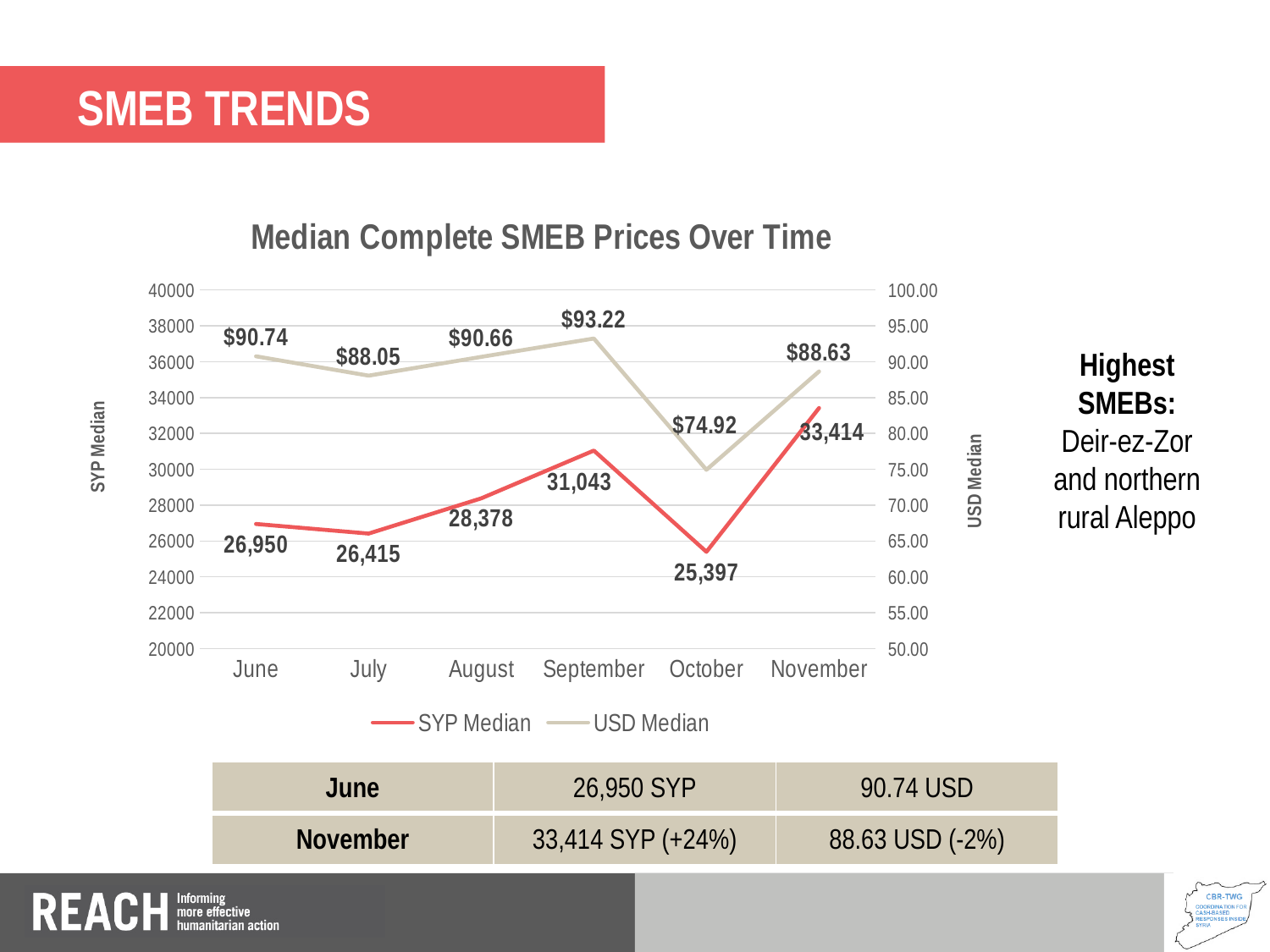
What is the SYP Median value for September? 31,043 What is the USD Median value for October? $74.92 What kind of chart is shown on the slide? Line chart Which is larger, the SYP Median in August or in October? August In which month is the SYP Median highest? November What is the USD Median value for July? $88.05 In which month is the USD Median lowest? October In which month is the USD Median highest? September What is the difference between the SYP Median in November and in June? 6,464 How many months are shown on the x axis? 6 How many series does the legend list? 2 What is the title of the chart? Median Complete SMEB Prices Over Time